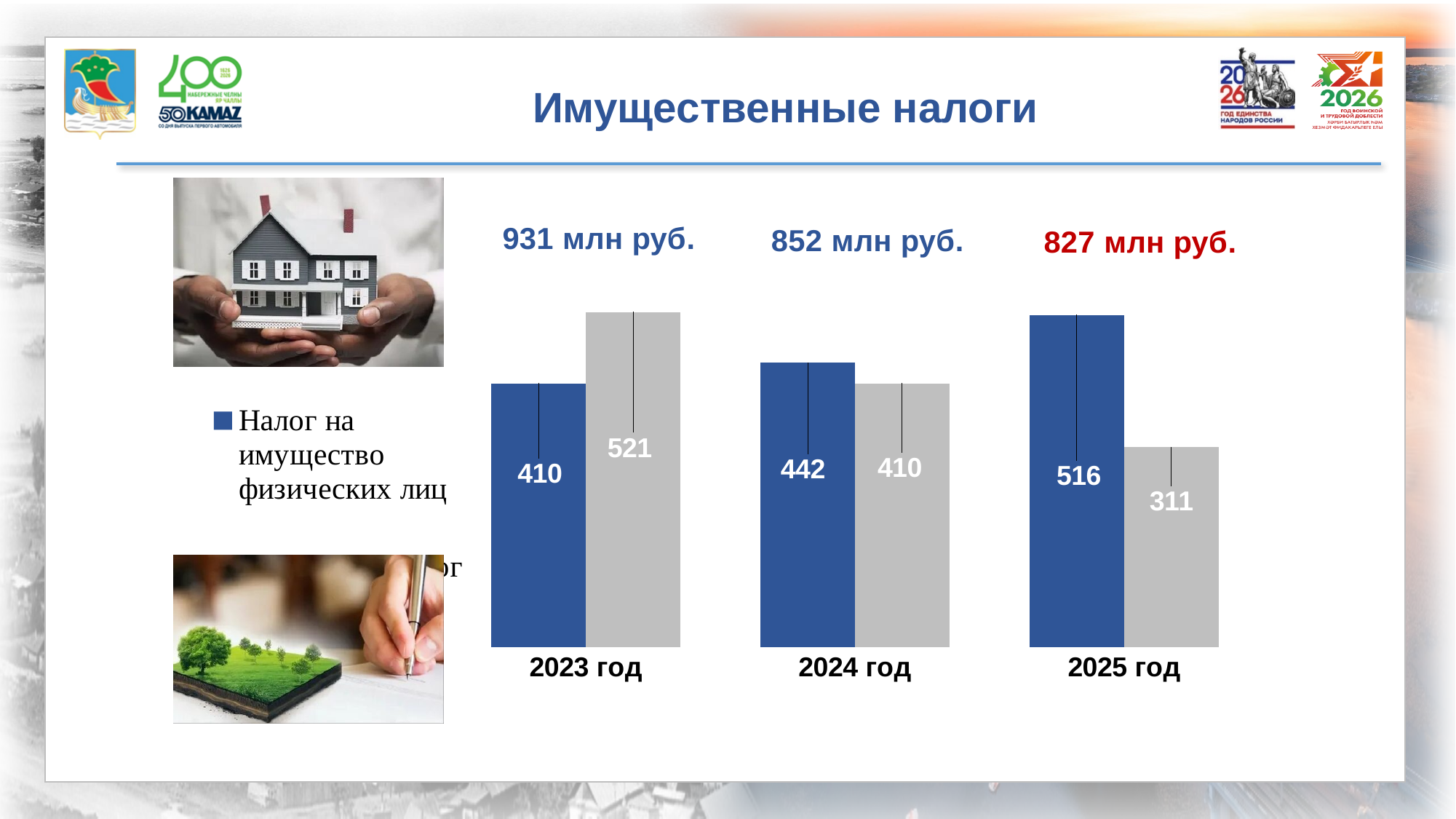
Does the blue series (Налог на имущество физических лиц) rise or fall from 2023 год to 2025 год? rises In which year is the blue bar (Налог на имущество физических лиц) the highest? 2025 год In which year is the grey bar the lowest? 2025 год What is the value of Налог на имущество физических лиц for 2024 год? 442 What is the value of the grey bar for 2025 год? 311 What total is printed above the bars for 2024 год? 852 млн руб. For 2023 год, which bar is larger: the blue bar or the grey bar? the grey bar What type of chart is shown on the slide? bar chart How many years are shown on the x axis of the chart? 3 What is the value of the blue bar (Налог на имущество физических лиц) for 2023 год? 410 What is the difference between the blue bar and the grey bar for 2025 год? 205 What is the title of the slide containing the chart? Имущественные налоги